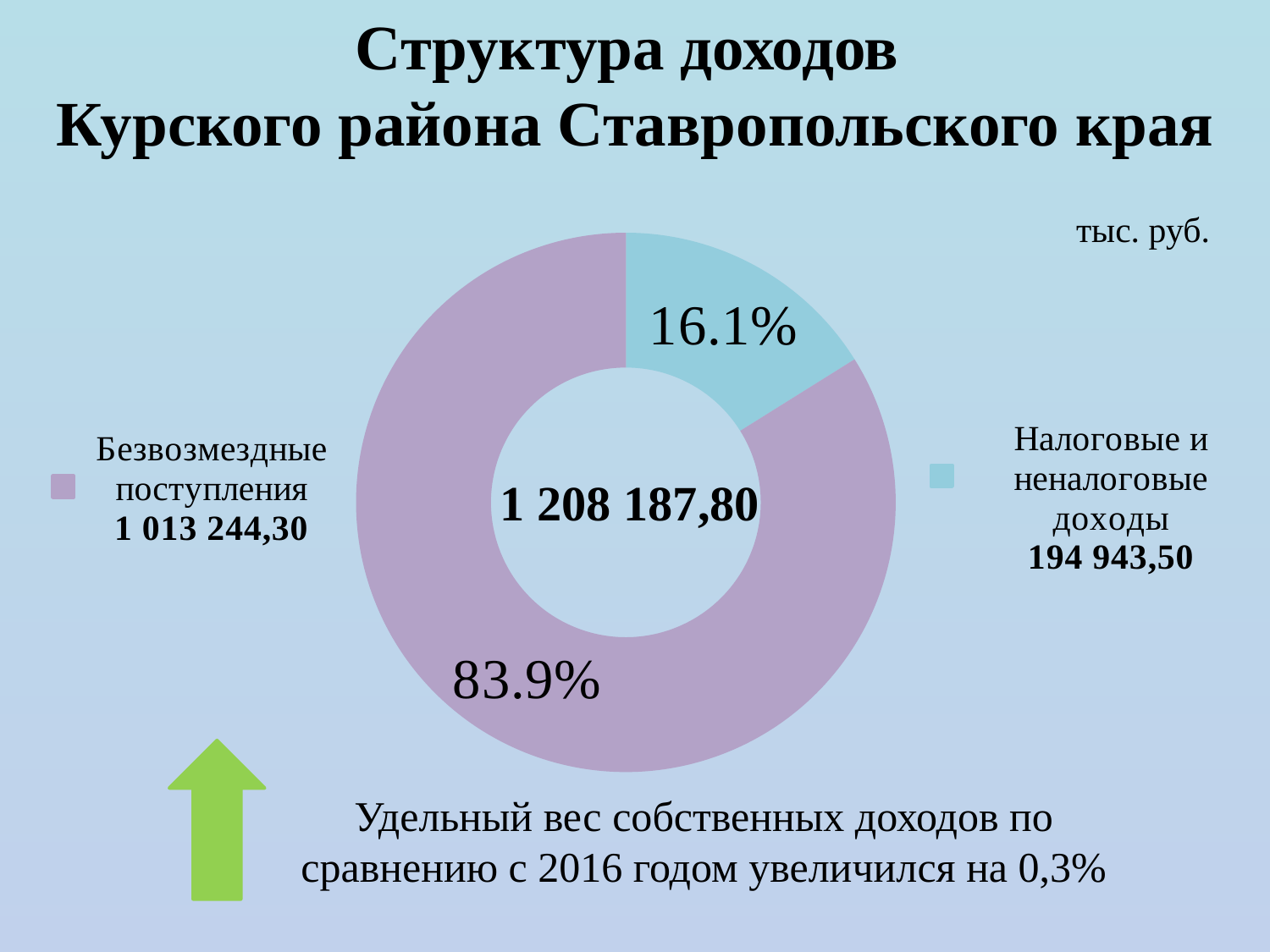
Which is larger: Безвозмездные поступления or Налоговые и неналоговые доходы? Безвозмездные поступления What is the value shown for Налоговые и неналоговые доходы? 194 943,50 What is the value shown for Безвозмездные поступления? 1 013 244,30 How many categories does the chart show? 2 What share of the doughnut chart does Безвозмездные поступления take? 83.9% What unit of measurement is indicated for the chart values? тыс. руб. What kind of chart is shown on the slide? doughnut chart What is the difference between the values for Безвозмездные поступления and Налоговые и неналоговые доходы? 818 300,80 What total value is printed in the centre of the doughnut chart? 1 208 187,80 Which category has the largest share of the chart? Безвозмездные поступления What share of the doughnut chart does Налоговые и неналоговые доходы take? 16.1% Which category has the smallest share of the chart? Налоговые и неналоговые доходы